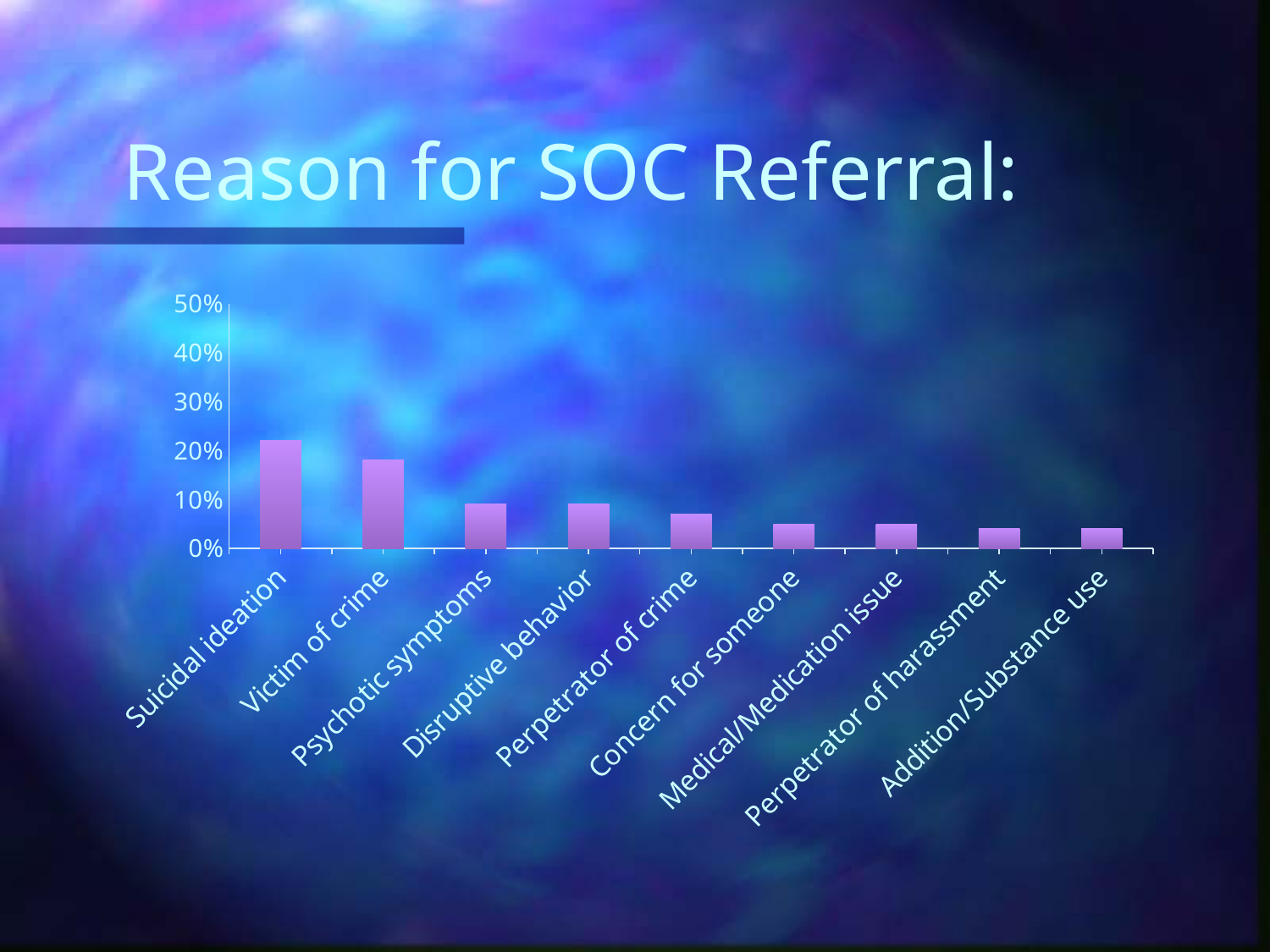
Is the value for Suicidal ideation greater or less than 20%? greater Do the values generally rise or fall moving from left to right along the x axis? fall Which category has the highest value in the chart? Suicidal ideation Is the value for Perpetrator of crime greater or less than 10%? less Is the value for Concern for someone greater or less than 10%? less What is the title of the slide containing the chart? Reason for SOC Referral: Which is larger, the value for Victim of crime or the value for Psychotic symptoms? Victim of crime How many categories are shown on the x axis of the chart? 9 Which is larger, the value for Suicidal ideation or the value for Victim of crime? Suicidal ideation What kind of chart is shown on the slide? bar chart